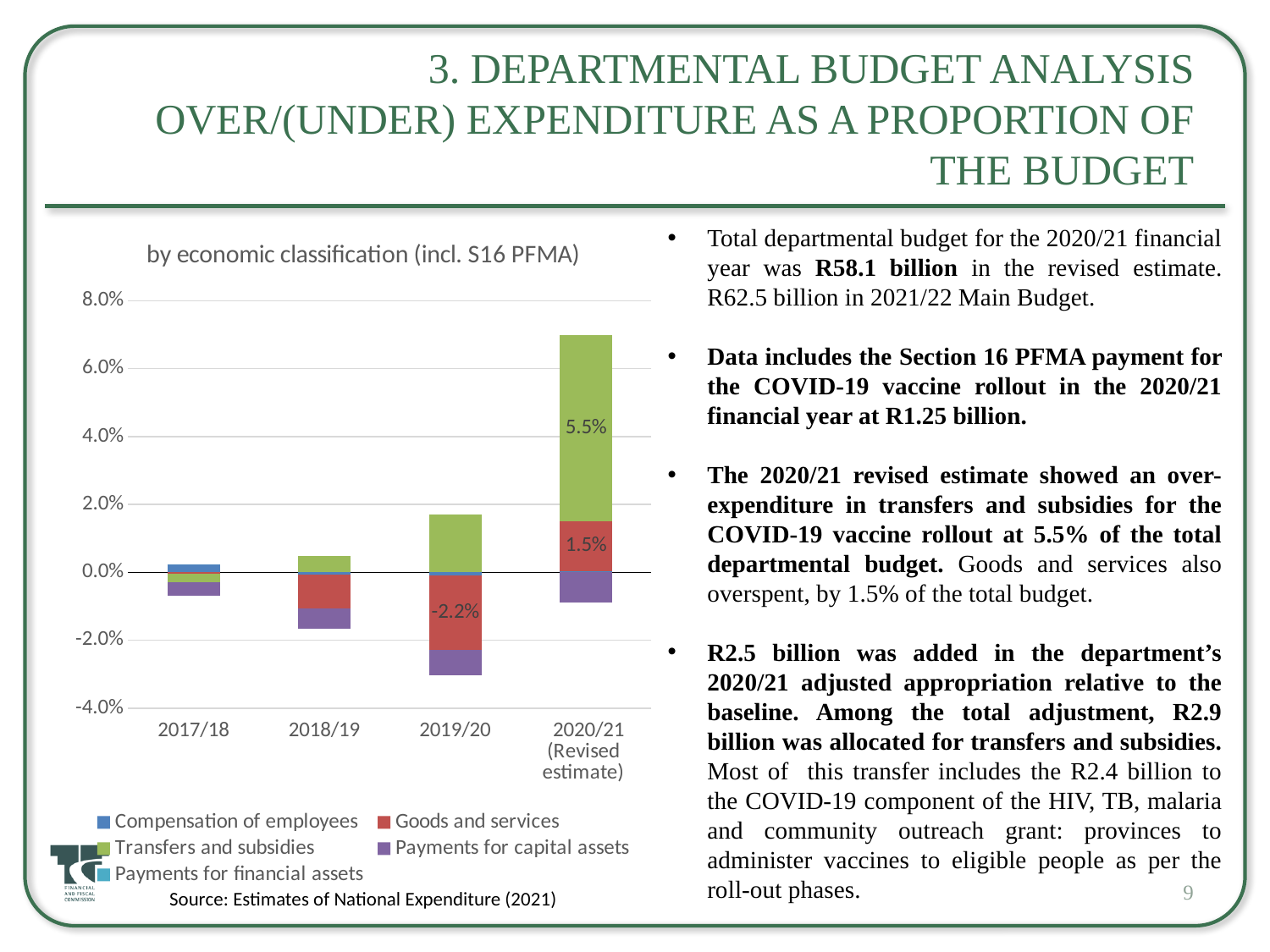
What is the labelled value for Goods and services in 2019/20? -2.2% Is the Transfers and subsidies value for 2020/21 (Revised estimate) greater or less than 4.0%? greater How many financial-year categories are shown on the x axis? 4 What is the difference between the Transfers and subsidies value (5.5%) and the Goods and services value (1.5%) in 2020/21 (Revised estimate)? 4.0% Which series is shown in green in the chart? Transfers and subsidies What is the title of the chart? by economic classification (incl. S16 PFMA) How many series does the chart legend list? 5 What is the labelled value for Transfers and subsidies in 2020/21 (Revised estimate)? 5.5% Is the Transfers and subsidies value for 2019/20 greater or less than 2.0%? less What is the labelled value for Goods and services in 2020/21 (Revised estimate)? 1.5% What kind of chart is shown on the slide? stacked bar chart Which year has the tallest positive stacked bar? 2020/21 (Revised estimate)